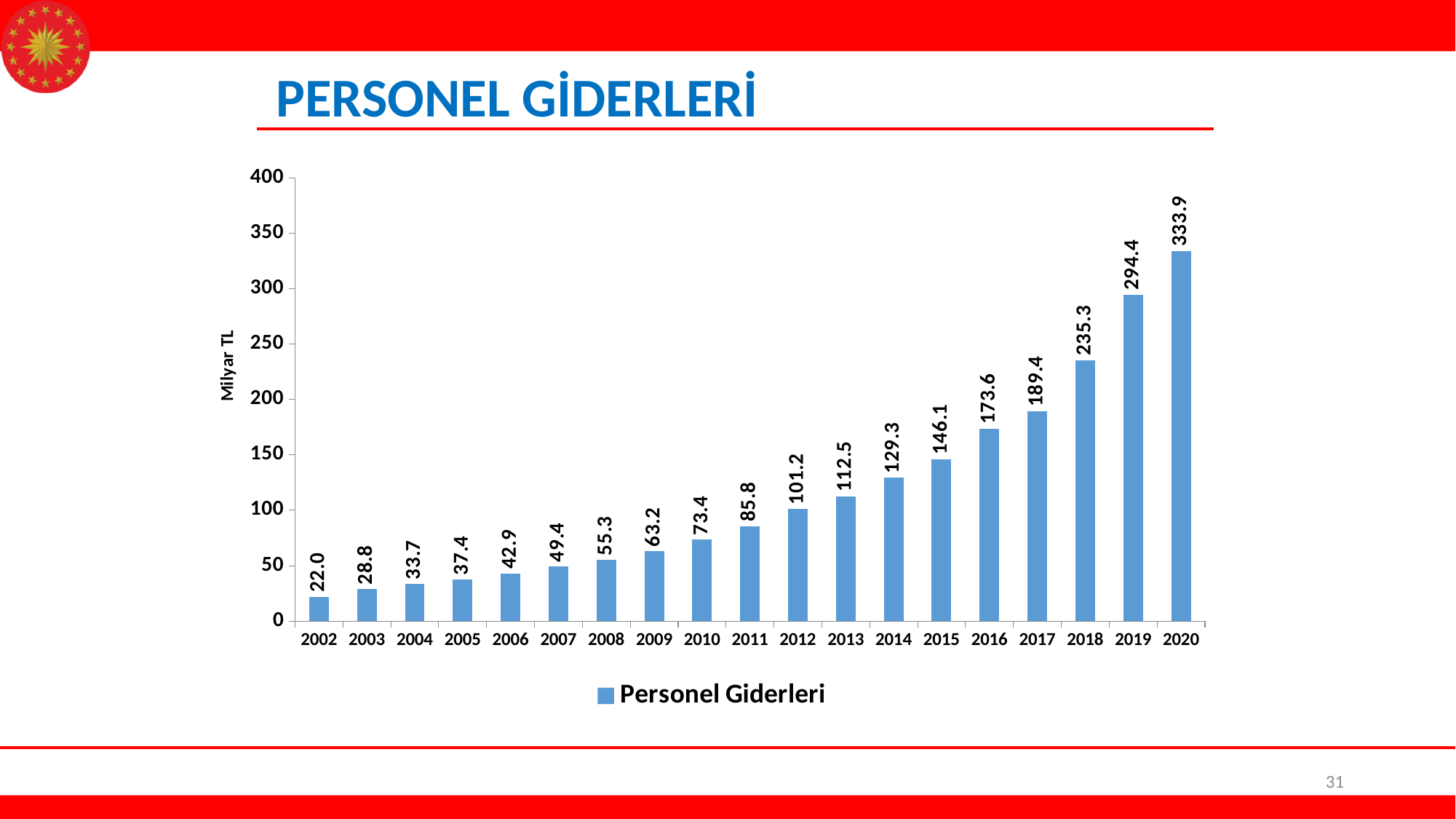
What is the value for 2010? 73.4 How many years are shown on the x axis? 19 Is the value for 2017 greater or less than 200? less Which is larger, the value for 2015 or the value for 2013? 2015 Which year has the highest value? 2020 How many series does the legend list? 1 What is the value for 2002? 22.0 What is the value for 2018? 235.3 What is the difference between the values for 2020 and 2019? 39.5 What kind of chart is shown? bar chart Do the values rise or fall from 2002 to 2020? rise Which year has the lowest value? 2002